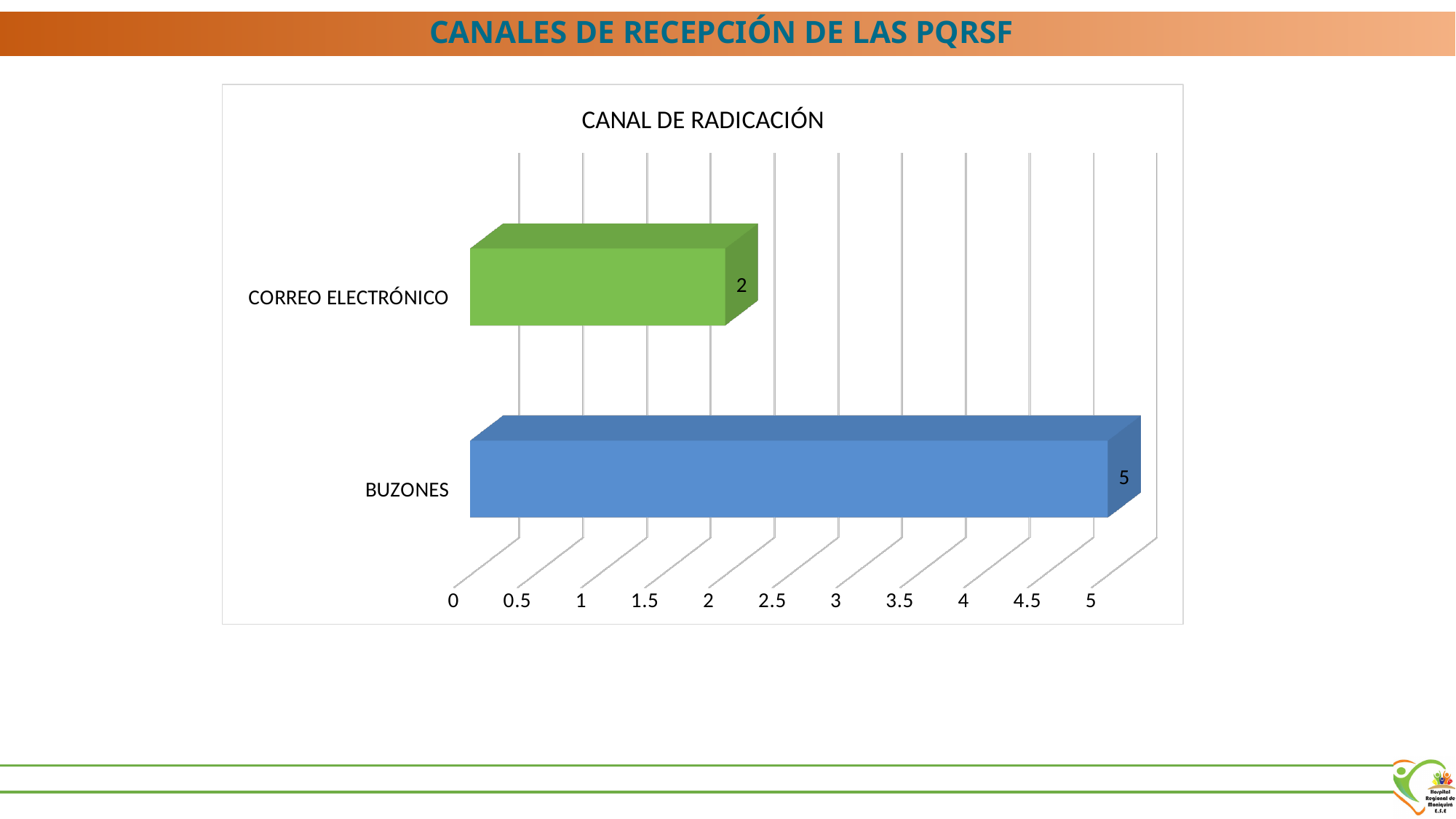
How many categories are shown in the chart? 2 Which category has the lowest value? CORREO ELECTRÓNICO Is the value for CORREO ELECTRÓNICO greater or less than 3? less What is the value for CORREO ELECTRÓNICO? 2 What is the value for BUZONES? 5 Which is larger, the value for BUZONES or the value for CORREO ELECTRÓNICO? BUZONES Which category has the highest value? BUZONES What kind of chart is shown on the slide? bar chart What is the title of the chart? CANAL DE RADICACIÓN What is the difference between the values for BUZONES and CORREO ELECTRÓNICO? 3 What colour is the bar for BUZONES? blue Is the value for BUZONES greater or less than 4? greater